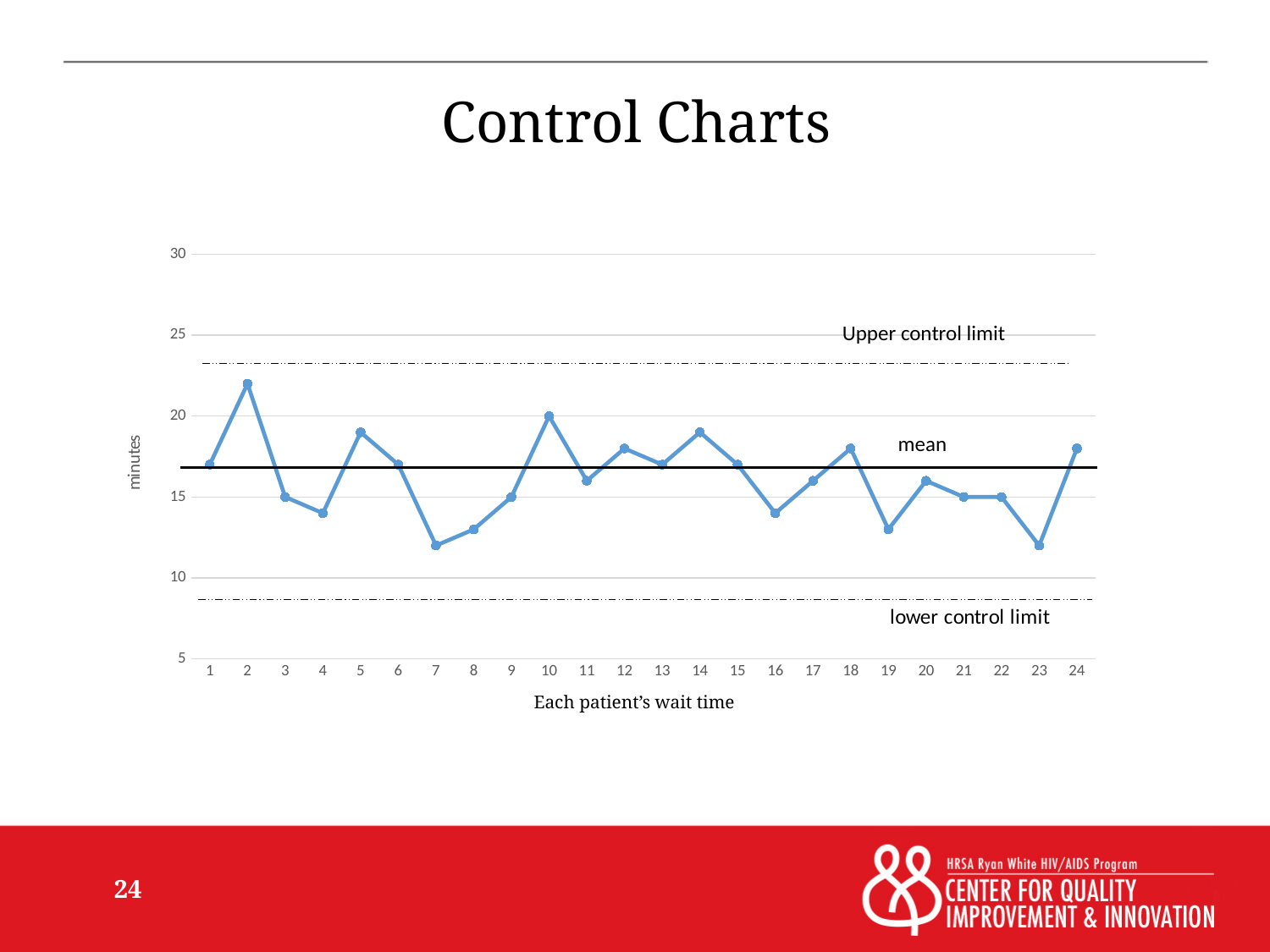
Which has the larger wait time, patient 2 or patient 10? patient 2 What is the label on the y axis of the chart? minutes Is the wait time for patient 5 greater or less than 15 minutes? greater Which patient number has the highest wait time? 2 Is the wait time for patient 7 greater or less than 15 minutes? less What kind of chart is shown on the slide? line chart What is the wait time in minutes for patient 10? 20 Which has the larger wait time, patient 5 or patient 7? patient 5 How many patients' wait times are plotted on the chart? 24 Is the wait time for patient 23 greater or less than 15 minutes? less What is the label on the x axis of the chart? Each patient's wait time